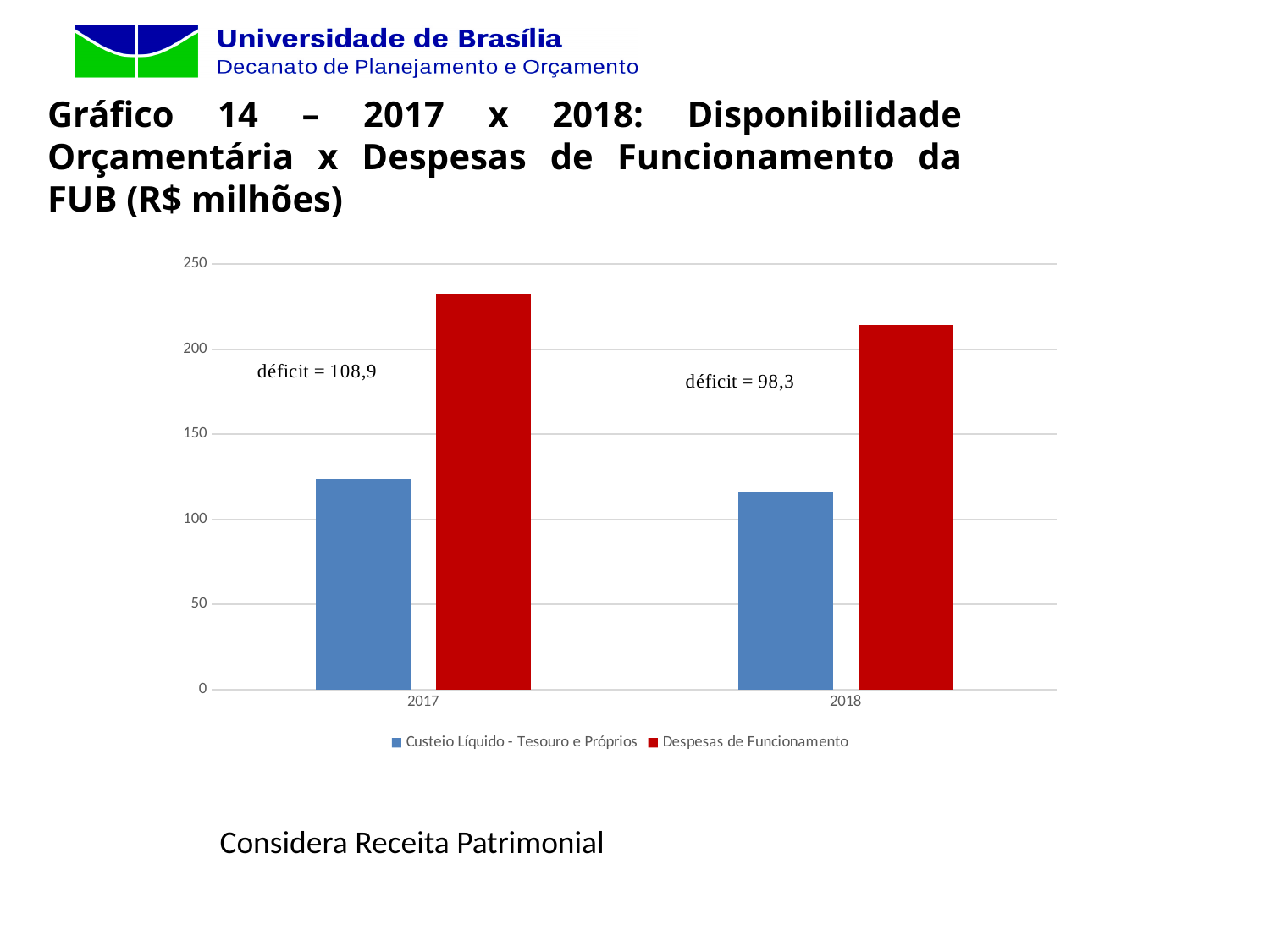
Which year has the higher value for Custeio Líquido - Tesouro e Próprios? 2017 How many years are shown on the x axis? 2 Is the value for Despesas de Funcionamento in 2017 greater or less than 200? greater Is the value for Custeio Líquido - Tesouro e Próprios in 2017 greater or less than 100? greater How many series does the legend list? 2 Is the value for Despesas de Funcionamento in 2018 greater or less than 200? greater Which year has the higher value for Despesas de Funcionamento, 2017 or 2018? 2017 Does the value for Despesas de Funcionamento rise or fall from 2017 to 2018? fall What kind of chart is shown on the slide? bar chart What déficit value is annotated on the chart for 2018? 98,3 What déficit value is annotated on the chart for 2017? 108,9